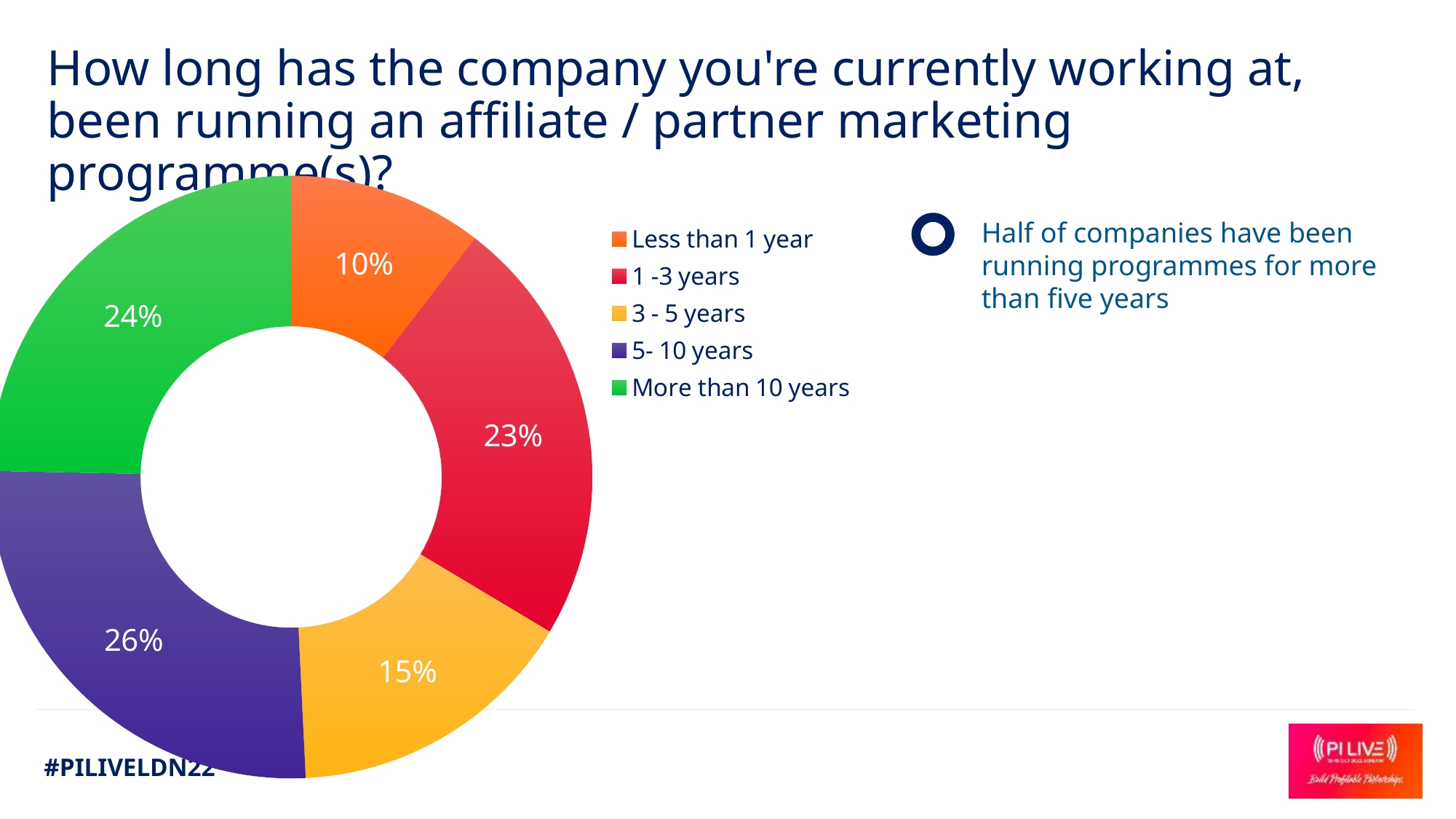
What colour is the slice for More than 10 years? Green What percentage of companies have been running a programme for 3 - 5 years? 15% Which category has the largest share of the pie? 5- 10 years What percentage of companies have been running a programme for more than 10 years? 24% How many categories does the pie chart show? 5 What is the difference in percentage points between the 5- 10 years slice and the 3 - 5 years slice? 11 What percentage of companies have been running an affiliate / partner marketing programme for less than 1 year? 10% Which category has the smallest share of the pie? Less than 1 year What percentage of companies have been running a programme for 5- 10 years? 26% What percentage of companies have been running a programme for 1 -3 years? 23% What kind of chart is shown on the slide? Pie chart (doughnut) Which is larger, the share for 1 -3 years or the share for 3 - 5 years? 1 -3 years